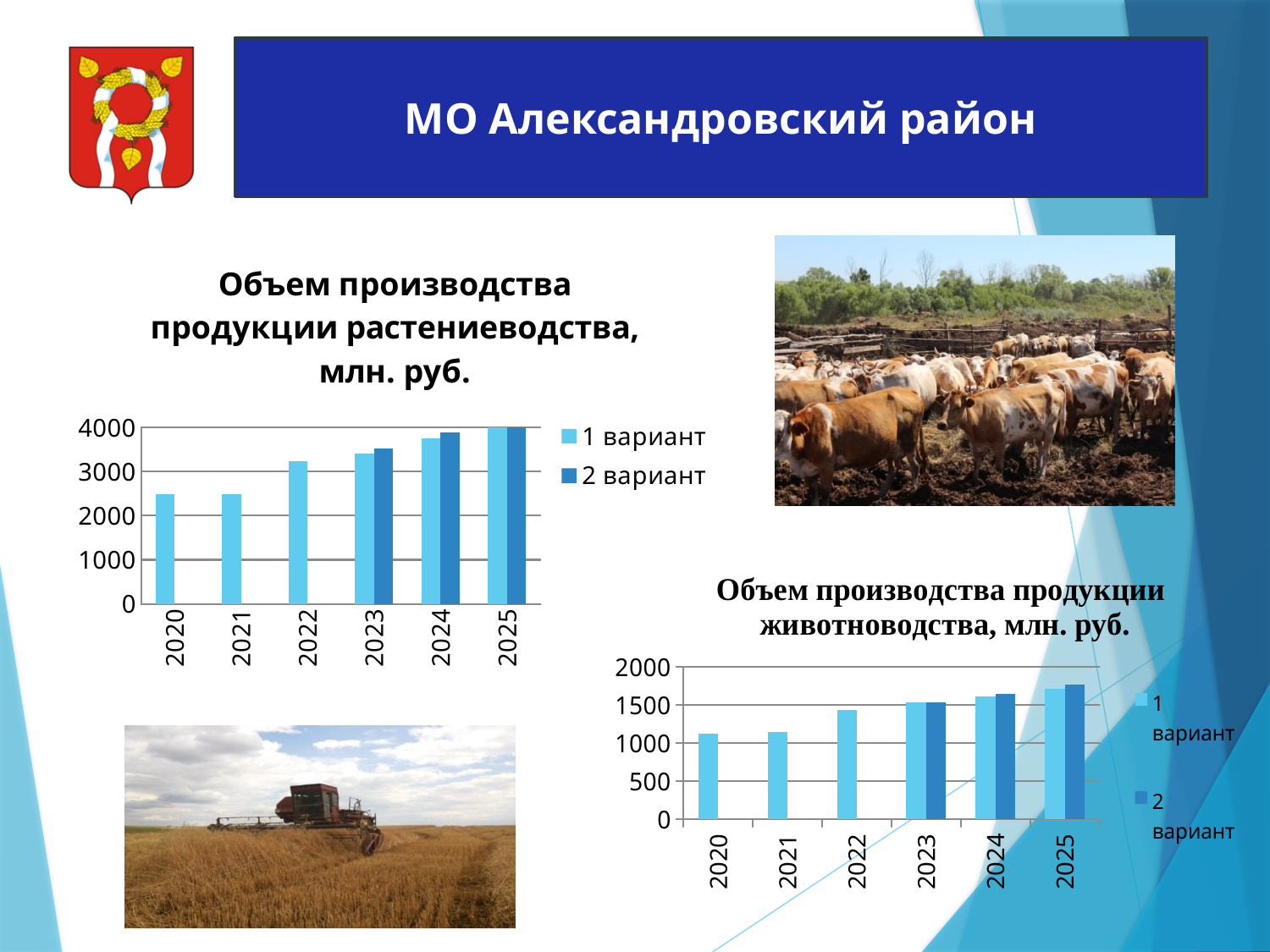
In the 'Объем производства продукции животноводства, млн. руб.' chart, which is larger: the '1 вариант' value for 2020 or for 2025? 2025 How many series does the legend of the 'Объем производства продукции растениеводства, млн. руб.' chart list? 2 In the 'Объем производства продукции растениеводства, млн. руб.' chart, do the '1 вариант' values generally rise or fall from 2020 to 2025? rise In the 'Объем производства продукции животноводства, млн. руб.' chart, is the value for '1 вариант' in 2021 greater or less than 1500? less How many series does the legend of the 'Объем производства продукции животноводства, млн. руб.' chart list? 2 In the 'Объем производства продукции растениеводства, млн. руб.' chart, which year has the lowest '1 вариант' value among 2022, 2023, 2024 and 2025? 2022 What type of chart is the 'Объем производства продукции животноводства, млн. руб.' chart? bar chart In the 'Объем производства продукции растениеводства, млн. руб.' chart, is the value for '1 вариант' in 2022 greater or less than 3000? greater In the 'Объем производства продукции растениеводства, млн. руб.' chart, is the value for '1 вариант' in 2020 greater or less than 3000? less What type of chart is the 'Объем производства продукции растениеводства, млн. руб.' chart? bar chart How many years are shown on the x axis of the 'Объем производства продукции растениеводства, млн. руб.' chart? 6